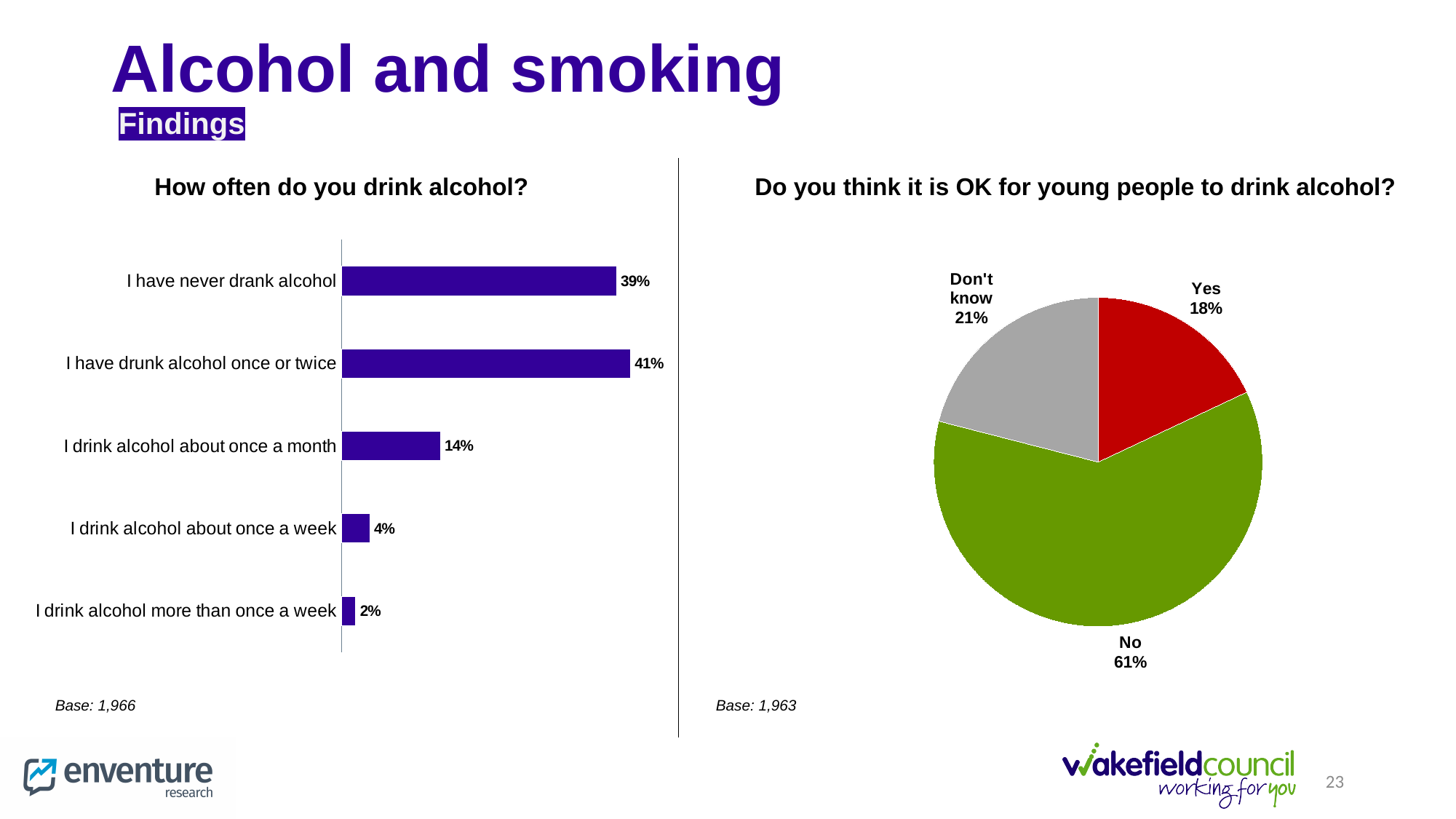
In the 'Do you think it is OK for young people to drink alcohol?' chart, what share of respondents answered 'No'? 61% In the 'Do you think it is OK for young people to drink alcohol?' chart, which is larger: 'Yes' or 'Don't know'? Don't know In the 'How often do you drink alcohol?' chart, which category has the lowest value? I drink alcohol more than once a week In the 'How often do you drink alcohol?' chart, what is the difference between 'I have drunk alcohol once or twice' and 'I have never drank alcohol'? 2% In the 'How often do you drink alcohol?' chart, which category has the highest value? I have drunk alcohol once or twice What type of chart is 'How often do you drink alcohol?'? Bar chart What type of chart is 'Do you think it is OK for young people to drink alcohol?'? Pie chart How many categories are shown in the 'How often do you drink alcohol?' chart? 5 In the 'How often do you drink alcohol?' chart, which is larger: 'I drink alcohol about once a week' or 'I drink alcohol more than once a week'? I drink alcohol about once a week In the 'How often do you drink alcohol?' chart, what is the value for 'I drink alcohol about once a month'? 14% In the 'How often do you drink alcohol?' chart, what percentage of respondents said 'I have never drank alcohol'? 39% In the 'Do you think it is OK for young people to drink alcohol?' chart, what is the value for 'Don't know'? 21%